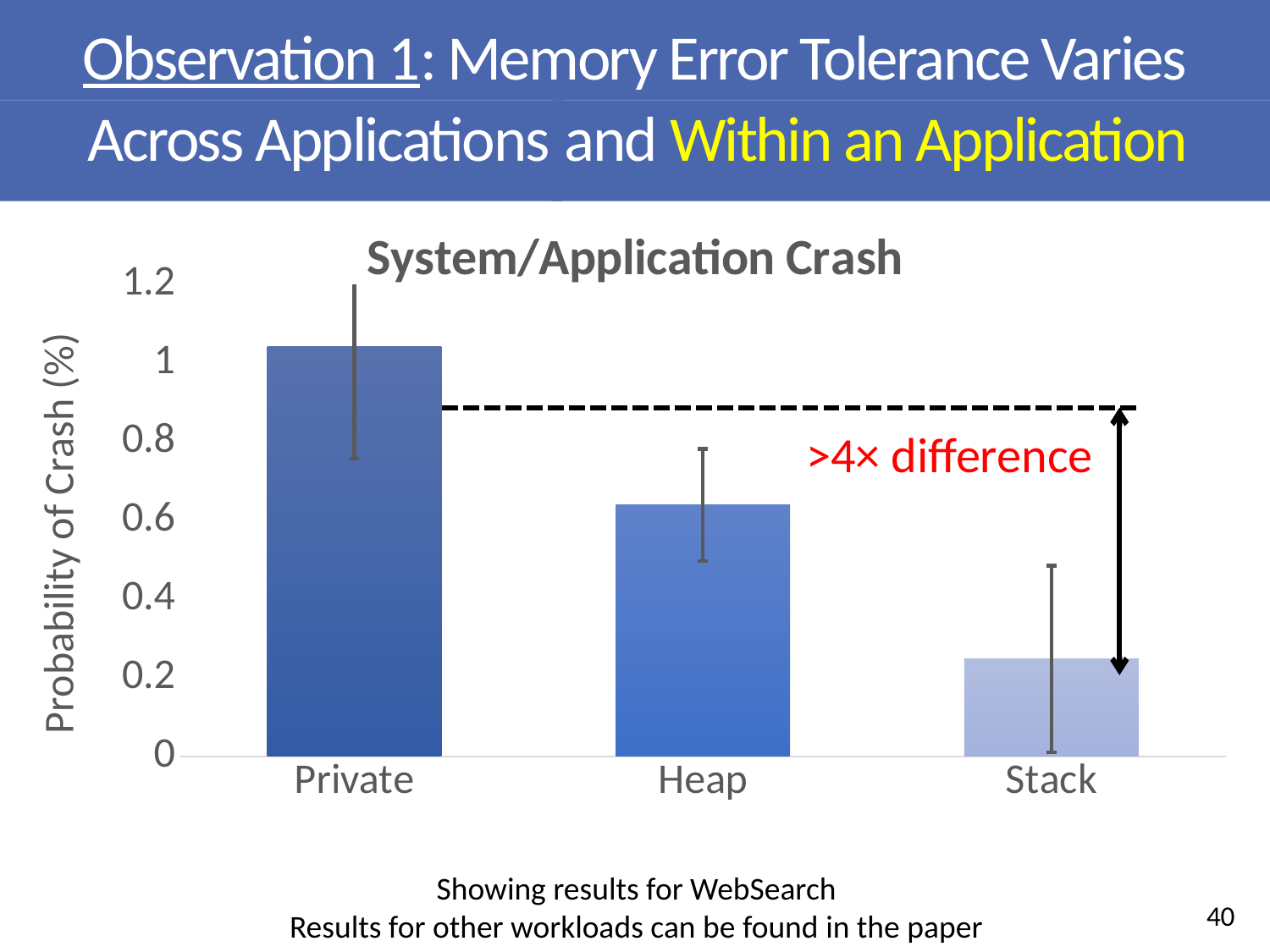
Which category has the lowest probability of crash? Stack What is the title of the chart? System/Application Crash Which category has the highest probability of crash? Private Do the bar values rise or fall from Private to Stack along the x axis? fall Is the value for Heap greater or less than 0.8? less Is the value for Stack greater or less than 0.4? less How many categories are shown on the x axis of the chart? 3 Is the value for Private greater or less than 0.8? greater Which has a higher probability of crash, Heap or Stack? Heap Which has a higher probability of crash, Private or Heap? Private What kind of chart is shown on the slide? bar chart